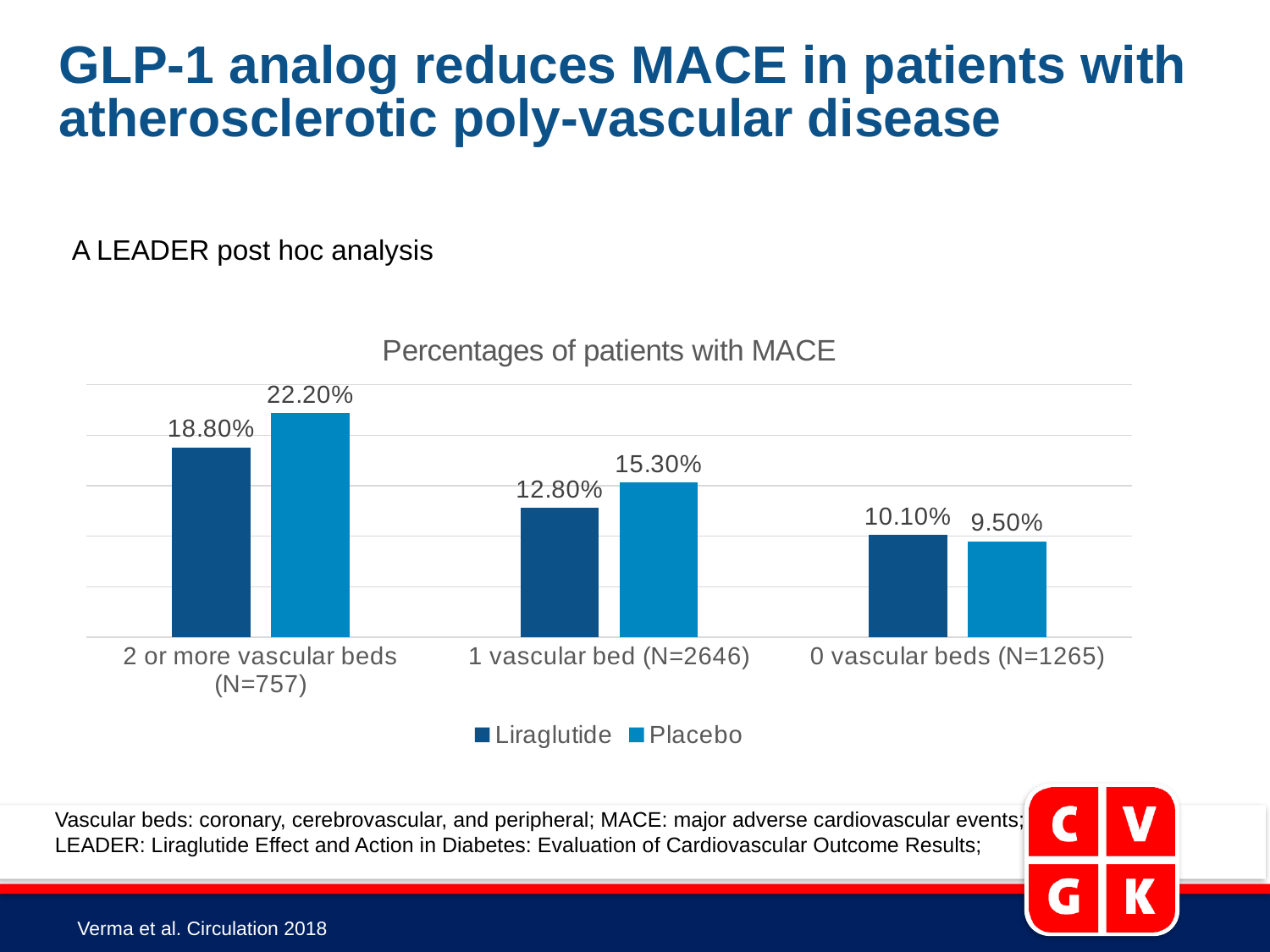
What is the percentage of patients with MACE for Placebo in the '0 vascular beds (N=1265)' group? 9.50% What is the percentage of patients with MACE for Placebo in the '1 vascular bed (N=2646)' group? 15.30% What is the percentage of patients with MACE for Liraglutide in the '2 or more vascular beds (N=757)' group? 18.80% Which category has the lowest Liraglutide value? 0 vascular beds (N=1265) How many series does the legend list? 2 What is the title of the chart? Percentages of patients with MACE How many categories are shown on the x axis of the chart? 3 In the '0 vascular beds (N=1265)' group, which is larger, the Liraglutide value or the Placebo value? Liraglutide Which category has the highest Placebo value? 2 or more vascular beds (N=757) What kind of chart is shown on the slide? Bar chart What is the difference between the Placebo and Liraglutide values in the '2 or more vascular beds (N=757)' group? 3.40% What is the difference between the Placebo and Liraglutide values in the '1 vascular bed (N=2646)' group? 2.50%